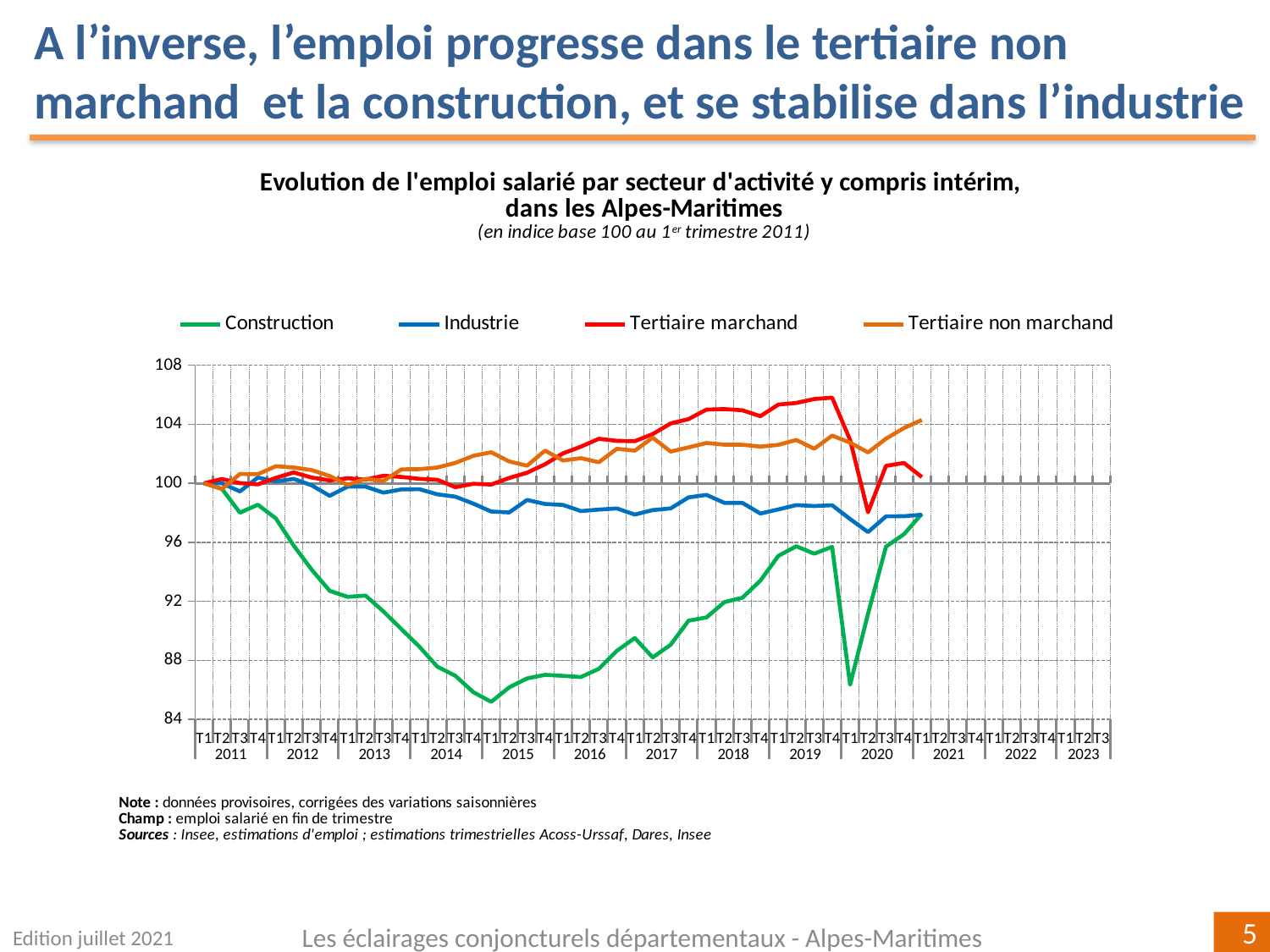
What is the title of the chart? Evolution de l'emploi salarié par secteur d'activité y compris intérim, dans les Alpes-Maritimes Is the value for Tertiaire marchand at T4 2019 greater or less than 104? greater Which series has the highest value at T4 2019? Tertiaire marchand Which series is shown in green in the chart? Construction Which series has the lowest value in 2015? Construction What kind of chart is shown on the slide? line chart Is the value for Construction at T2 2020 greater or less than 88? greater Is the value for Construction at T1 2015 greater or less than 88? less What is the index value of all series at T1 2011? 100 How many series does the legend list? 4 Does the Construction series rise or fall between 2011 and T1 2015? fall